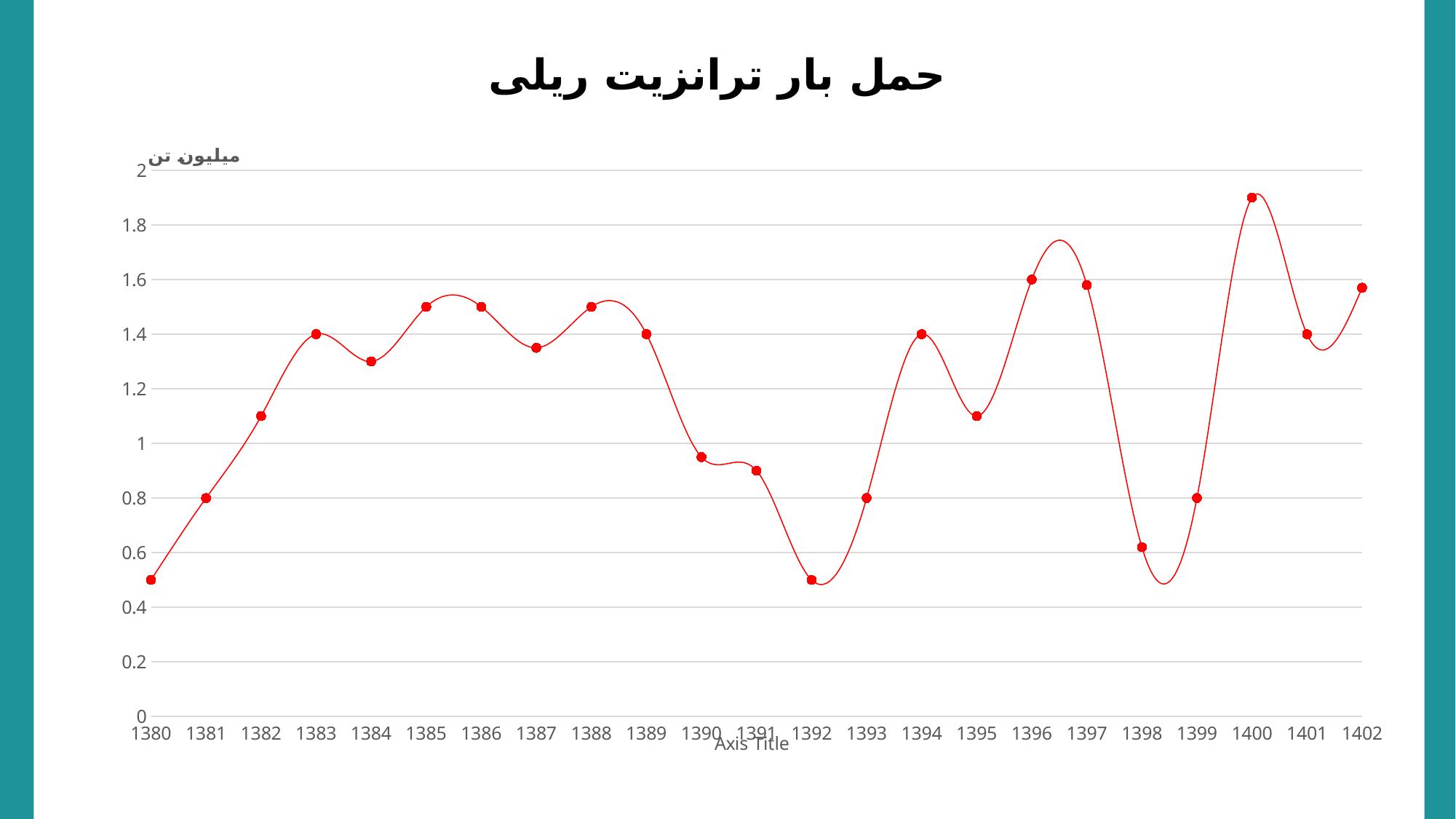
Which has the larger value, 1395 or 1396? 1396 What is the title of the chart? حمل بار ترانزیت ریلی Do the values rise or fall from 1380 to 1383? rise Is the value for 1400 greater or less than 1.8? greater Which has the larger value, 1383 or 1384? 1383 What kind of chart is shown on the slide? line chart Is the value for 1382 greater or less than 1? greater Is the value for 1392 greater or less than 0.6? less What unit label is shown at the top of the vertical axis? میلیون تن How many data points are plotted on the line? 23 Which year has the highest value on the chart? 1400